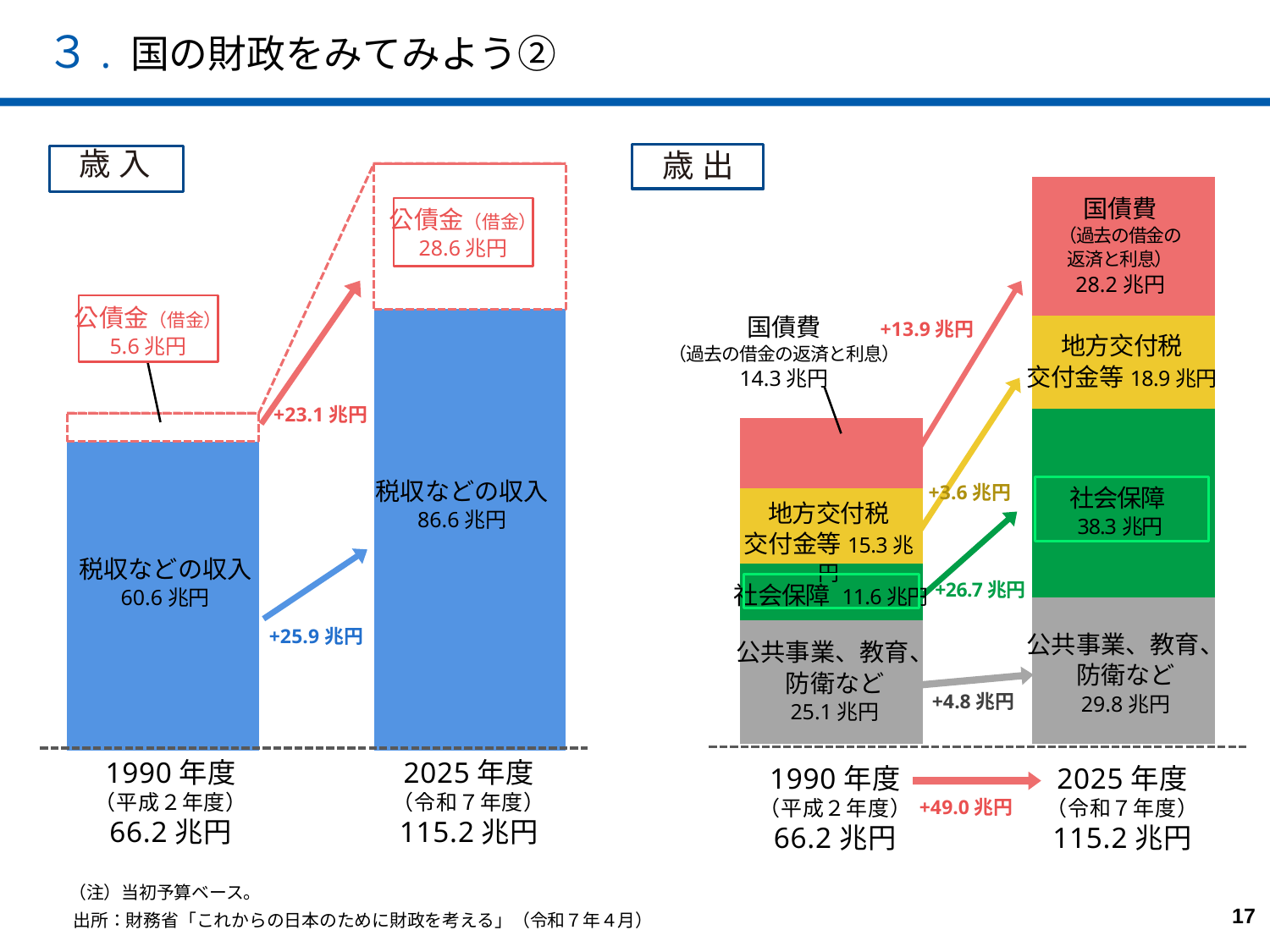
歳出のグラフで、1990年度の国債費はいくらですか？ 14.3兆円 歳出のグラフは、1つの年度の棒をいくつの項目に分けていますか？ 4 歳入のグラフで、1990年度から2025年度にかけて公債金はいくら増えましたか？ +23.1兆円 歳出のグラフで、2025年度に最も大きい項目はどれですか？ 社会保障 歳入のグラフで、2025年度の公債金（借金）はいくらですか？ 28.6兆円 歳入のグラフで、2025年度の歳入合計はいくらですか？ 115.2兆円 歳入のグラフで、1990年度の税収などの収入はいくらですか？ 60.6兆円 歳出のグラフで、1990年度に最も小さい項目はどれですか？ 社会保障 歳出のグラフで、2025年度の国債費と地方交付税交付金等の差はいくらですか？ 9.3兆円 歳出のグラフで、2025年度の社会保障はいくらですか？ 38.3兆円 歳入のグラフで、1990年度の税収などの収入と公債金では、どちらが大きいですか？ 税収などの収入 歳出のグラフで、1990年度から2025年度にかけて社会保障はいくら増えましたか？ +26.7兆円